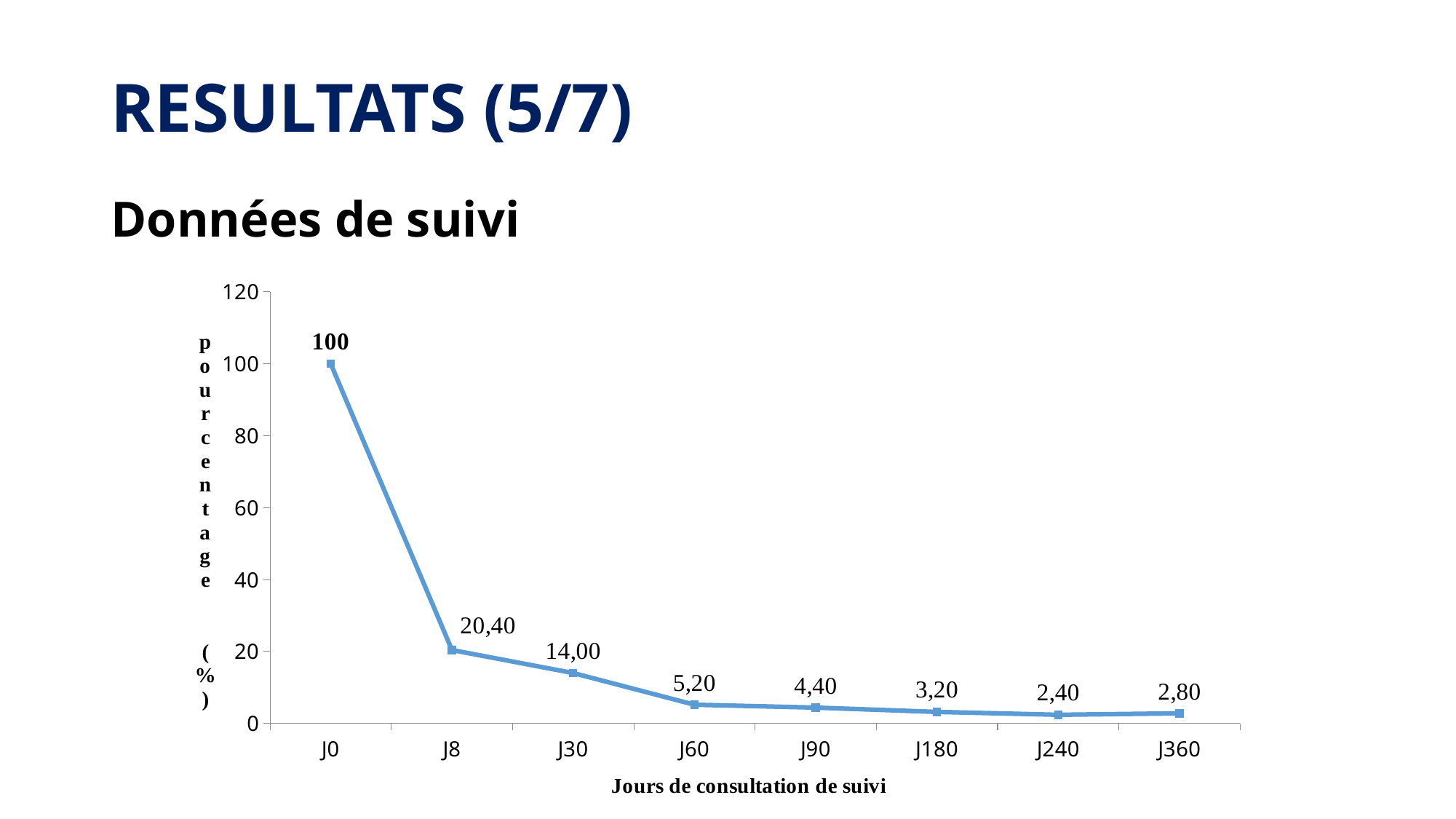
What is the value at J60? 5,20 How many data points are plotted on the chart? 8 Is the value at J30 greater or less than 20? less Do the values rise or fall from J0 to J240? fall What kind of chart is shown? line chart What is the x-axis title of the chart? Jours de consultation de suivi Which is larger, the value at J90 or the value at J180? J90 What is the value at J360? 2,80 Which day has the lowest percentage? J240 What is the difference between the values at J8 and J30? 6,40 What is the value at J8? 20,40 Which day has the highest percentage? J0